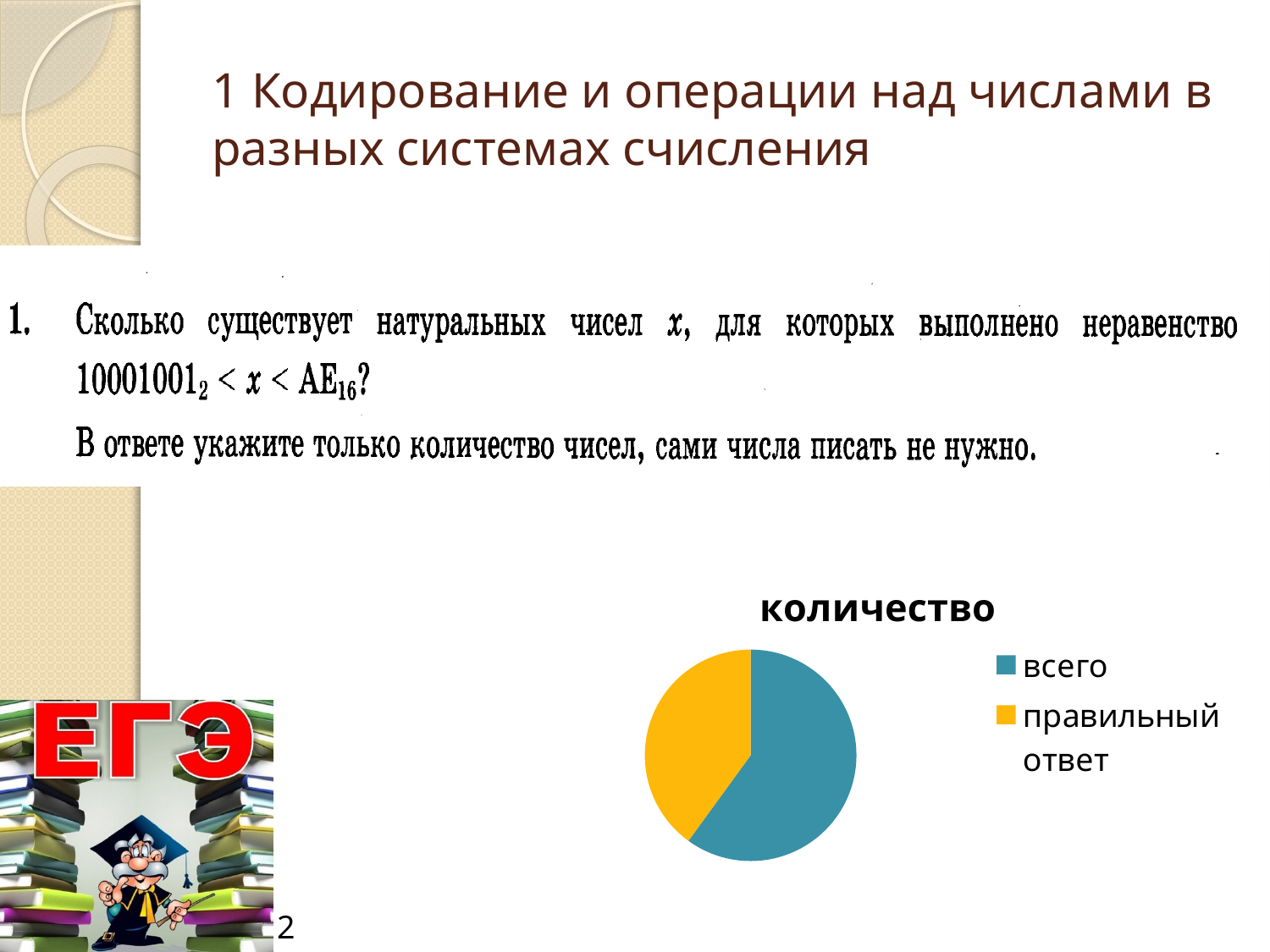
How many entries does the legend of the pie chart list? 2 Which slice is larger in the pie chart, "всего" or "правильный ответ"? всего What is the title of the pie chart? количество How many slices does the pie chart have? 2 What kind of chart is shown on the slide? pie chart Which slice of the pie chart is the smallest? правильный ответ What colour is the "правильный ответ" slice in the pie chart? yellow Which slice of the pie chart is the largest? всего